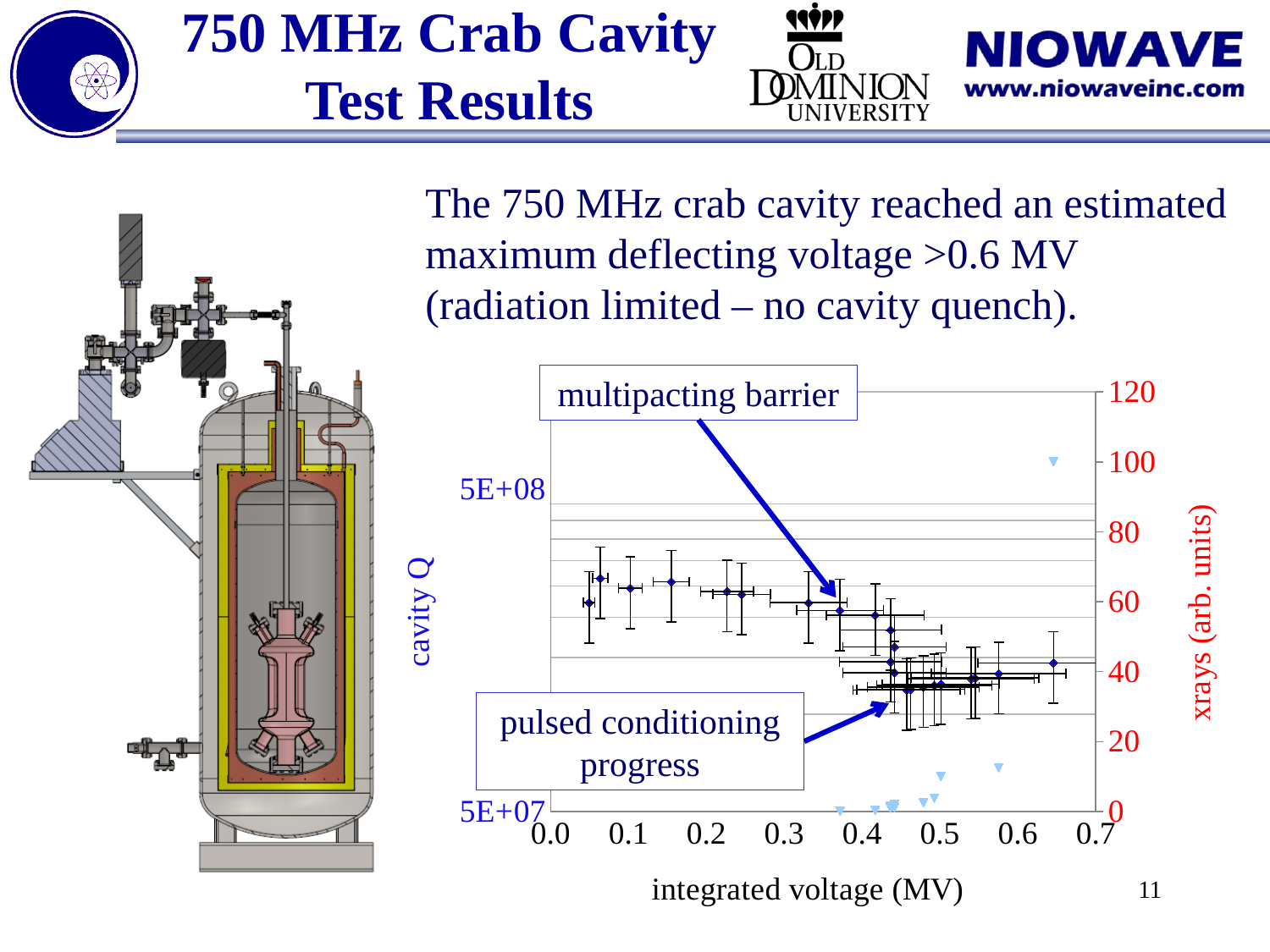
What is the label of the right-hand y axis of the chart? xrays (arb. units) What is the label of the x axis of the chart? integrated voltage (MV) Which is larger, the cavity Q at about 0.1 MV or the cavity Q at about 0.65 MV? cavity Q at about 0.1 MV What kind of chart is shown on the slide? scatter chart As integrated voltage increases along the x axis, do the x-ray readings rise or fall? rise Is the x-ray reading at about 0.5 MV greater or less than 20 arb. units? less As integrated voltage increases along the x axis, does cavity Q rise or fall? fall Is the highest x-ray reading on the chart greater or less than 80 arb. units? greater Is the cavity Q at the lowest integrated voltage (about 0.05 MV) greater or less than 5E+08? less